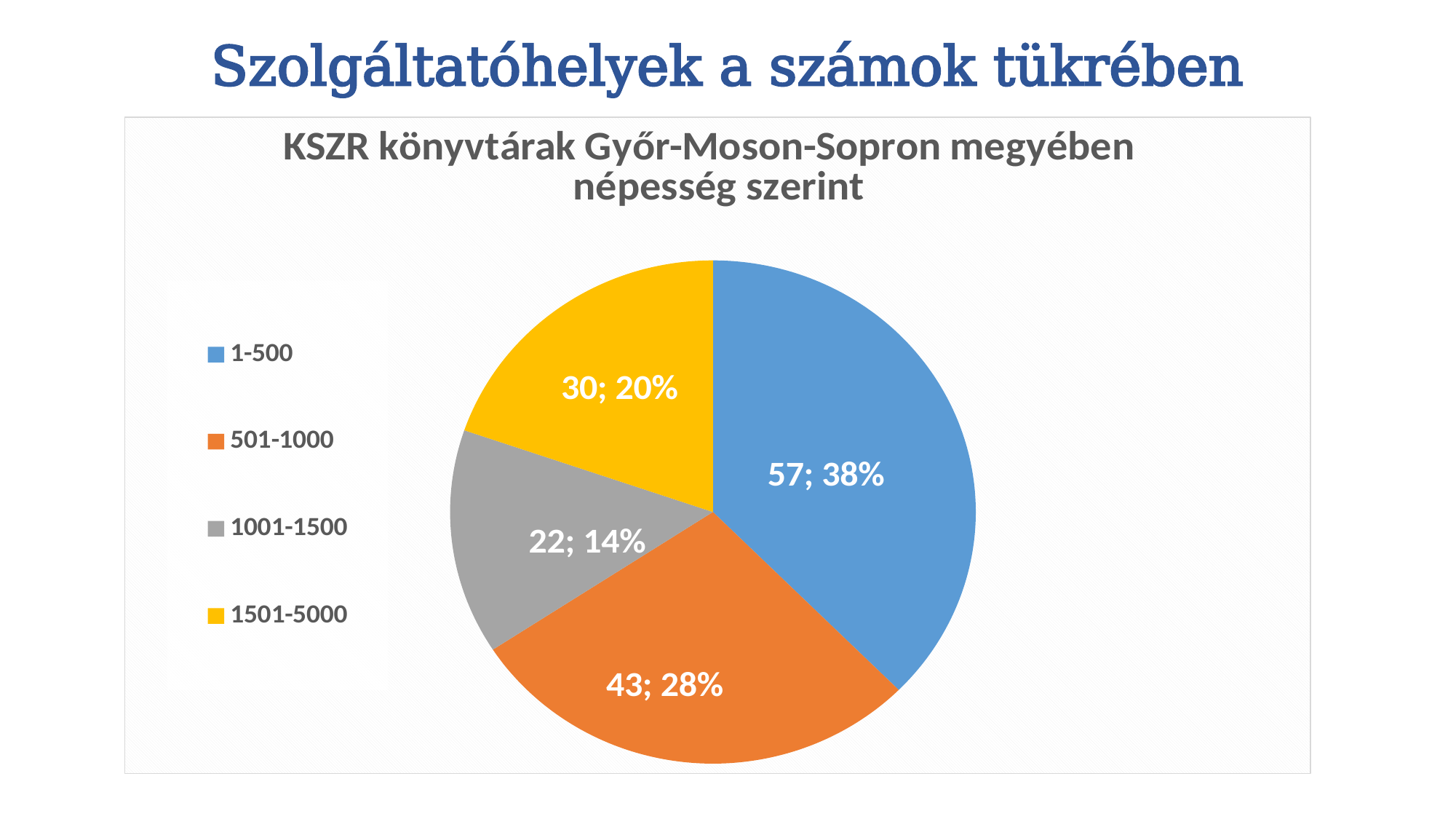
What kind of chart is shown on the slide? pie chart Which category has the smallest slice? 1001-1500 What is the value for the 1501-5000 category? 30 What is the difference between the values for 1-500 and 501-1000? 14 Which category has the largest slice? 1-500 What share of the pie does the 1501-5000 slice represent? 20% How many slices does the pie chart have? 4 What is the value for the 1-500 category? 57 What is the title of the chart? KSZR könyvtárak Győr-Moson-Sopron megyében népesség szerint What is the value for the 501-1000 category? 43 What is the value for the 1001-1500 category? 22 What share of the pie does the 1-500 slice represent? 38%